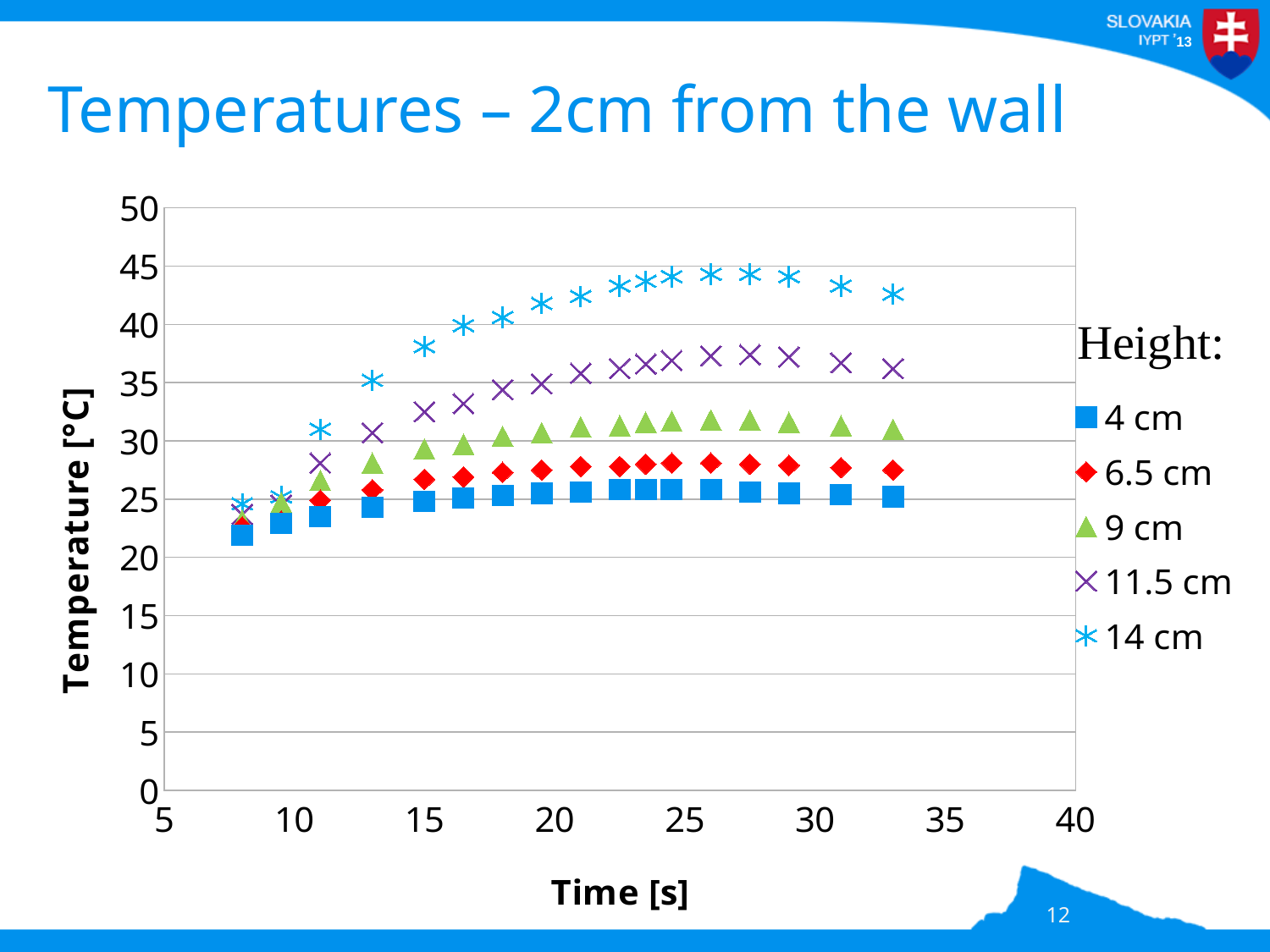
Is the temperature for the 14 cm series at 25 s greater or less than 40? greater At 20 s, which series has the higher temperature, 9 cm or 6.5 cm? 9 cm How many series does the legend list? 5 What are the series names listed in the legend? 4 cm, 6.5 cm, 9 cm, 11.5 cm, 14 cm What is the title of the chart? Temperatures – 2cm from the wall Which height series reaches the highest temperature? 14 cm Is the temperature for the 4 cm series at 25 s greater or less than 30? less Does the temperature for the 14 cm series rise or fall between 10 s and 25 s? rise What kind of chart is shown on the slide? scatter chart Which height series has the lowest temperatures throughout? 4 cm Is the temperature for the 11.5 cm series at 30 s greater or less than 35? greater